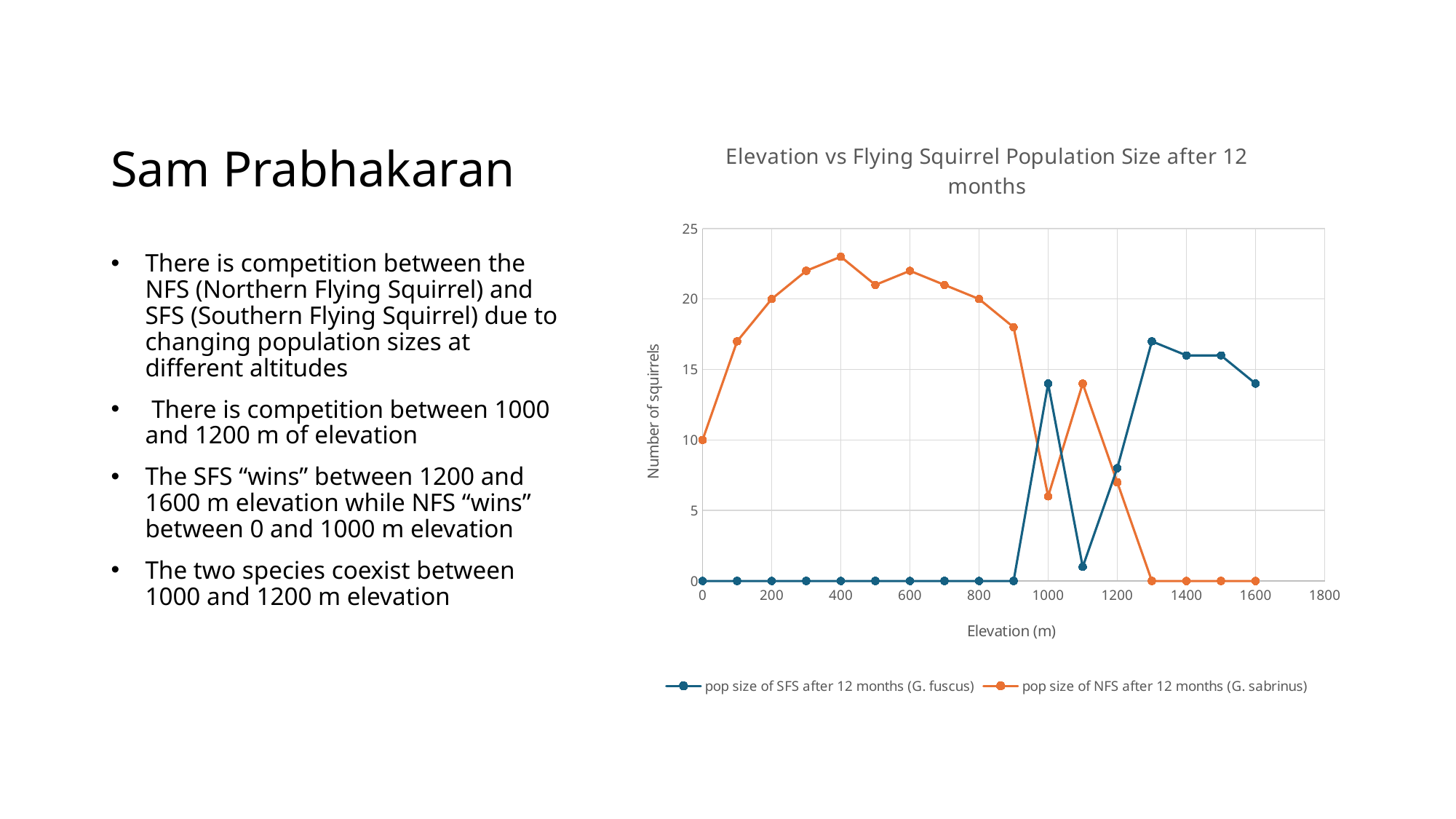
Does the NFS population size rise or fall between 0 m and 400 m elevation? rise What is the population size of NFS after 12 months at 200 m elevation? 20 Is the SFS population size at 1300 m elevation greater or less than 15? greater Is the NFS population size at 400 m elevation greater or less than 20? greater What is the population size of NFS after 12 months at 1400 m elevation? 0 What is the population size of NFS after 12 months at 0 m elevation? 10 How many series does the legend list? 2 At 1000 m elevation, which species has the larger population size, SFS or NFS? SFS Is the SFS population size at 1100 m elevation greater or less than 5? less What is the population size of SFS after 12 months at 400 m elevation? 0 What kind of chart is shown on the slide? line chart At which elevation does the NFS population size reach its highest value? 400